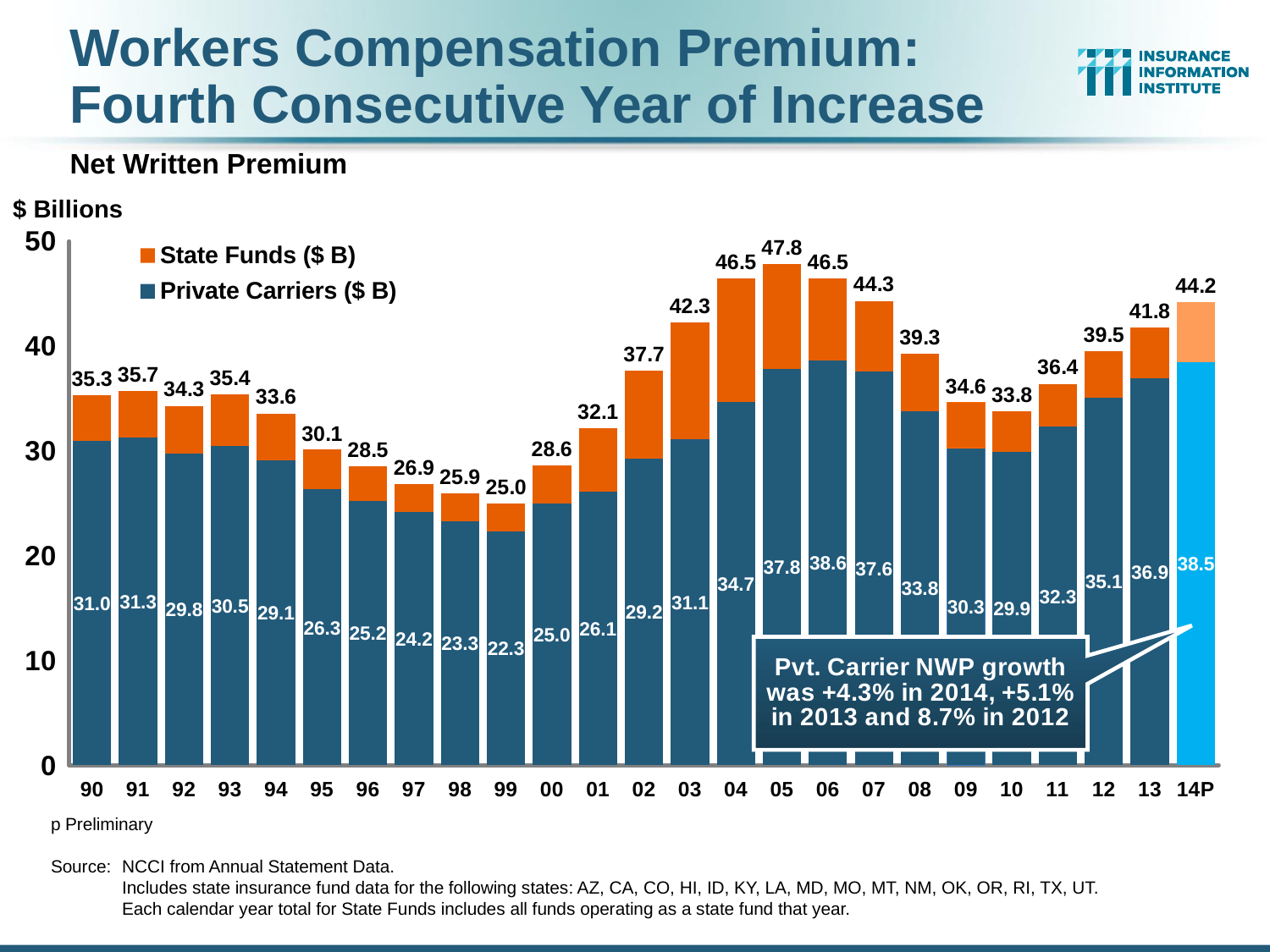
What kind of chart is shown? Stacked bar chart What is the State Funds portion for 2005, given the total of 47.8 and Private Carriers of 37.8? 10.0 How many series does the legend list? 2 Which year has the lowest Private Carriers value? 99 What was the total net written premium in 2005? 47.8 Which is larger, the total for 2004 or the total for 2006? They are equal (46.5) Is the State Funds portion of the 2005 bar greater or less than 20? less By how much did the total net written premium change from 13 to 14P? 2.4 What was the total net written premium in 1999? 25.0 How many years are shown on the x axis? 25 What was the Private Carriers value for 14P? 38.5 Which year has the highest total net written premium? 05